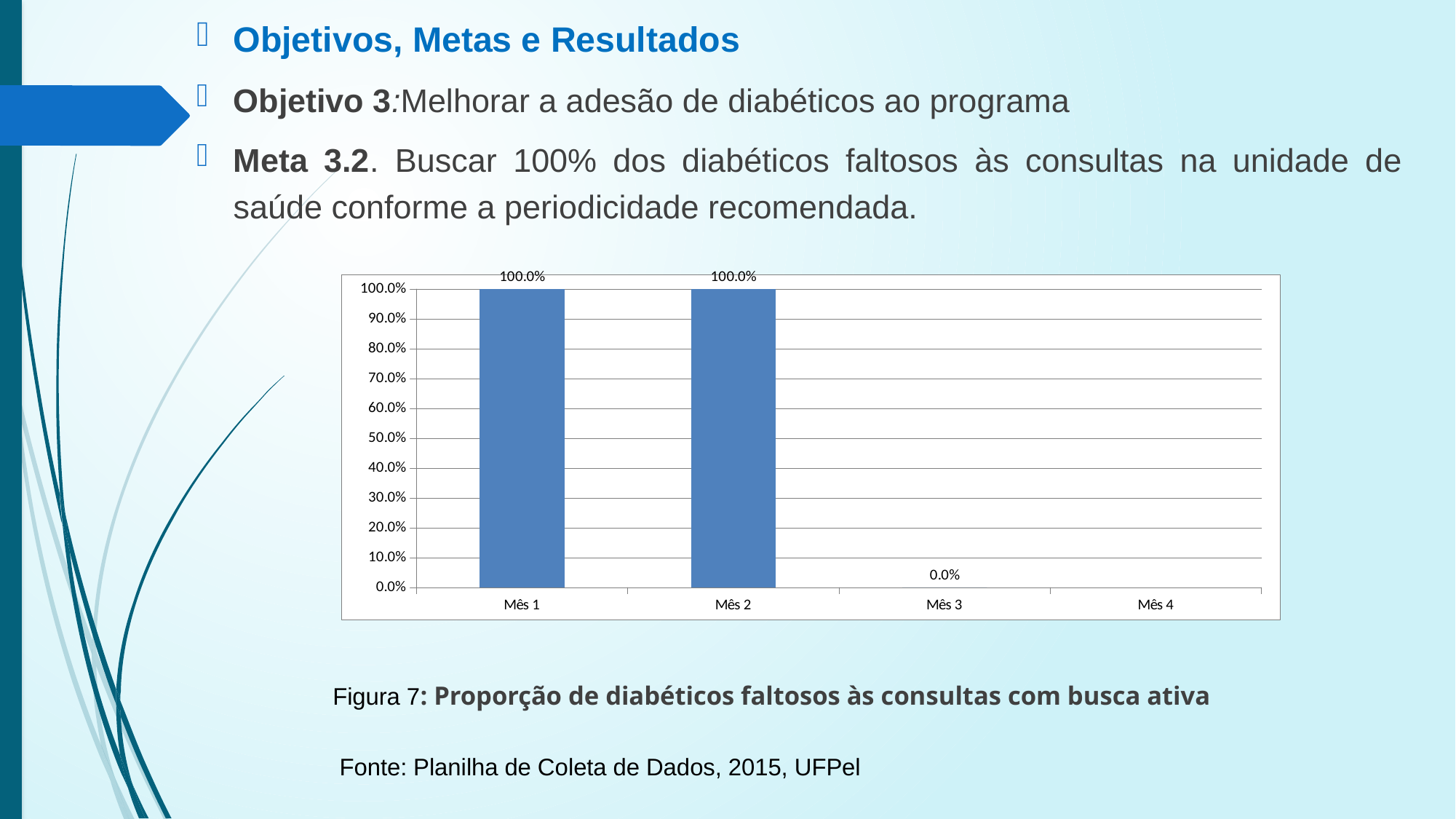
Is the value for Mês 1 greater or less than 50.0%? greater Is the value for Mês 3 greater or less than 10.0%? less What is the figure caption given for the chart? Figura 7: Proporção de diabéticos faltosos às consultas com busca ativa How many categories are shown on the x axis of the chart? 4 What is the value for Mês 2? 100.0% What is the value for Mês 1? 100.0% What is the difference between the values for Mês 1 and Mês 3? 100.0% Do the values rise or fall from Mês 2 to Mês 3? fall Which is larger, the value for Mês 2 or the value for Mês 3? Mês 2 What is the value for Mês 3? 0.0% What kind of chart is shown on the slide? Bar chart What source is cited below the chart? Planilha de Coleta de Dados, 2015, UFPel